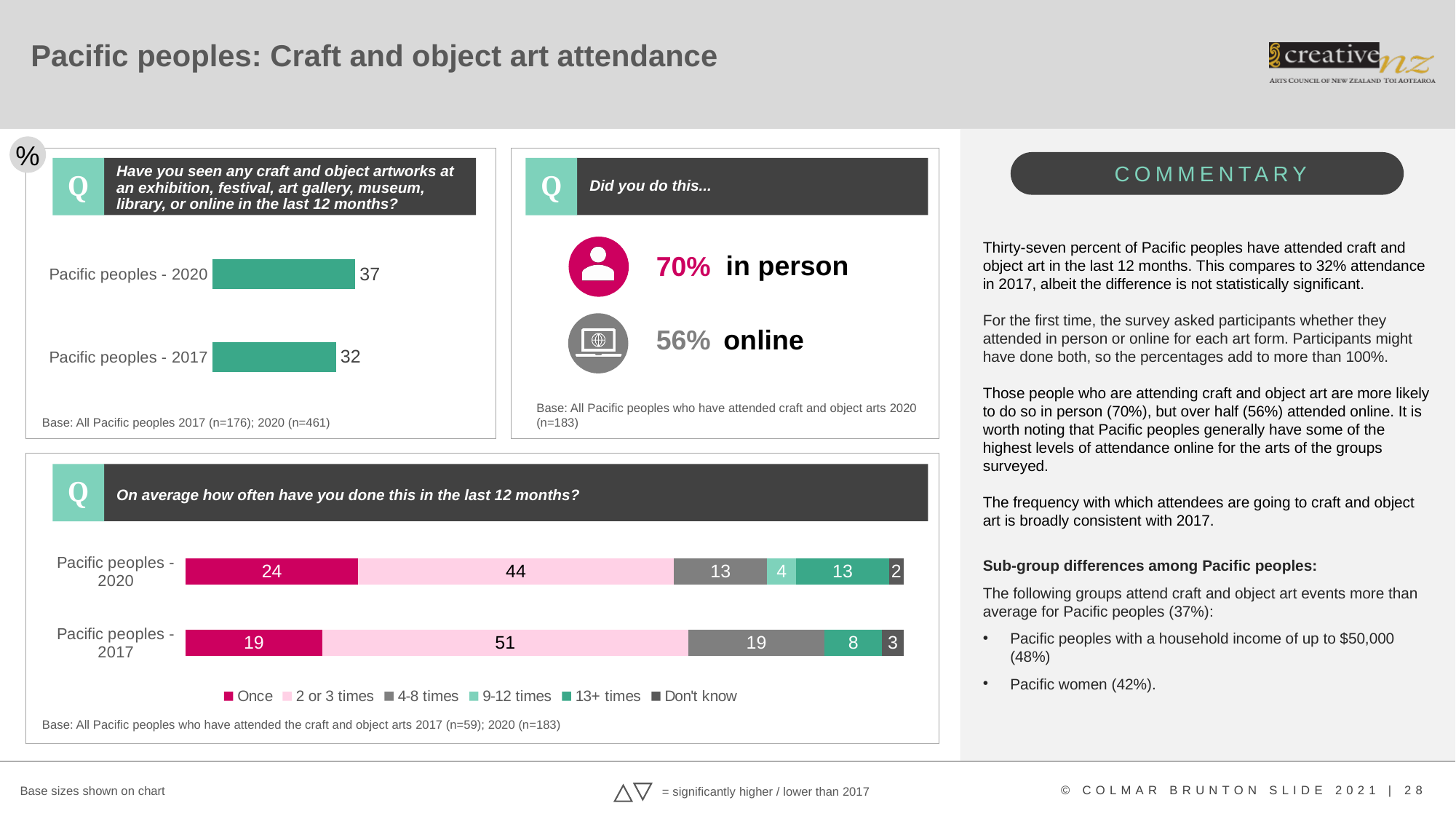
In the bottom chart on how often people have done this, which frequency category has the largest value for Pacific peoples - 2017? 2 or 3 times In the bottom chart on how often people have done this, what is the value for 'Once' for Pacific peoples - 2017? 19 In the top-left chart on craft and object art attendance, what is the value for Pacific peoples - 2020? 37 In the top-left chart on craft and object art attendance, which year has the higher value, 2020 or 2017? 2020 In the top-left chart on craft and object art attendance, what is the difference between the 2020 and 2017 values? 5 In the bottom chart on how often people have done this, what is the value for '13+ times' for Pacific peoples - 2020? 13 In the bottom chart on how often people have done this, what is the total of the stacked bar for Pacific peoples - 2020? 100 In the top-left chart on craft and object art attendance, what is the value for Pacific peoples - 2017? 32 In the bottom chart on how often people have done this, what is the difference between the '2 or 3 times' values for 2017 and 2020? 7 In the bottom chart on how often people have done this, what is the value for '2 or 3 times' for Pacific peoples - 2020? 44 In the bottom chart on how often people have done this, how many series does the legend list? 6 What type of chart is the top-left chart on craft and object art attendance? Bar chart